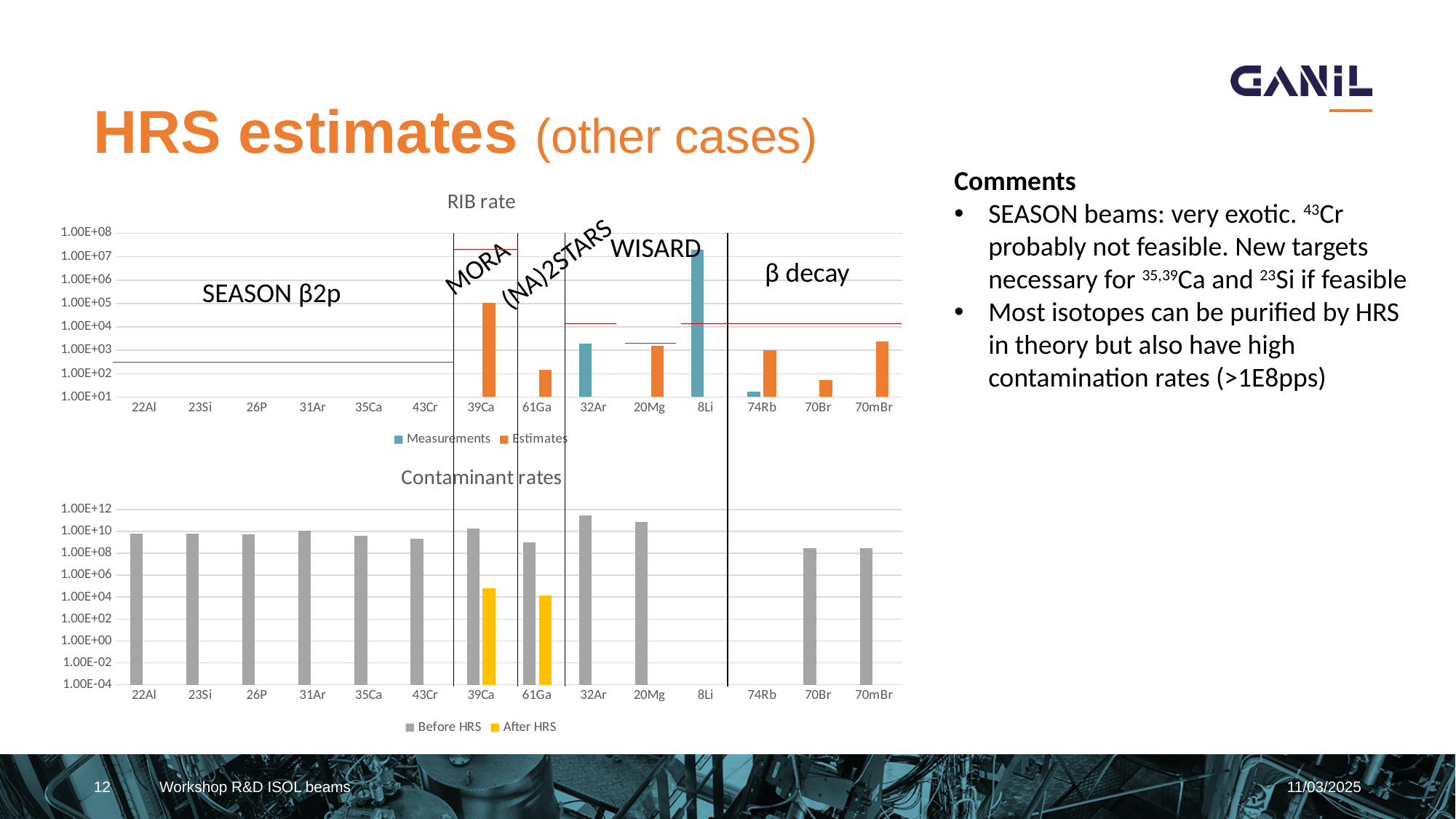
What are the two legend entries of the Contaminant rates chart? Before HRS, After HRS In the RIB rate chart, is the Measurements value for 32Ar greater or less than 1.00E+03? greater In the Contaminant rates chart, is the Before HRS value for 32Ar greater or less than 1.00E+10? greater How many categories are shown on the x axis of the Contaminant rates chart? 14 In the RIB rate chart, is the Measurements value for 8Li greater or less than 1.00E+06? greater In the Contaminant rates chart, which category has the highest Before HRS bar? 32Ar In the RIB rate chart, which category has the highest bar? 8Li How many series does the legend of the RIB rate chart list? 2 What kind of chart is the Contaminant rates chart? bar chart In the RIB rate chart, which is larger, the Estimates value for 39Ca or for 61Ga? 39Ca